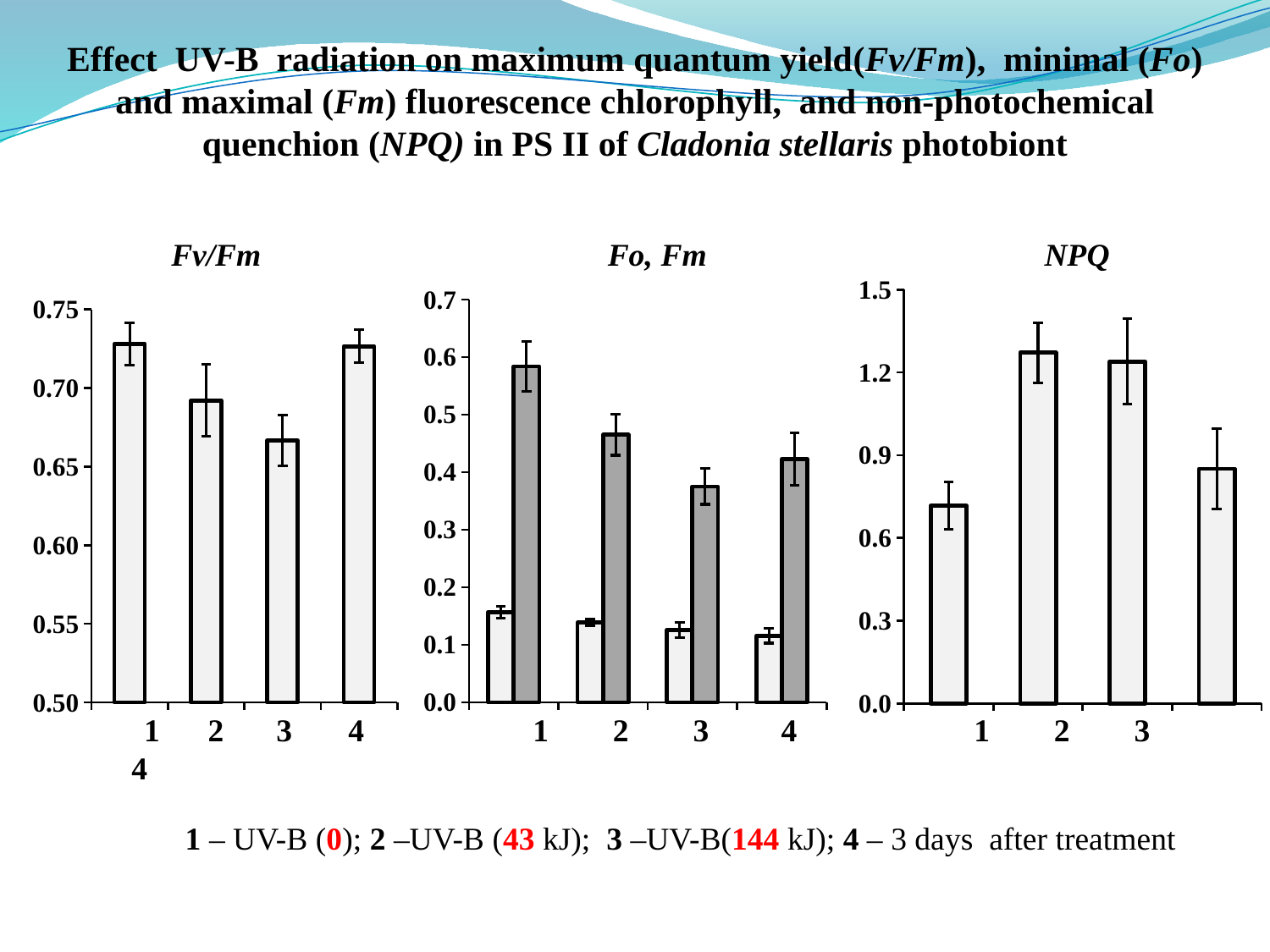
In the Fv/Fm chart, which category has the lowest value? 3 In the Fo, Fm chart, which category has the highest dark grey bar? 1 In the Fv/Fm chart, how many categories are shown on the x axis? 4 In the Fo, Fm chart, is the light grey bar for category 1 greater or less than 0.2? less In the Fv/Fm chart, is the value for category 1 greater or less than 0.70? greater In the Fv/Fm chart, is the value for category 3 greater or less than 0.70? less In the Fo, Fm chart, do the dark grey bars rise or fall from category 1 to category 3? fall What kind of chart is the Fv/Fm chart? bar chart In the NPQ chart, which category has the lowest value? 1 How many charts are shown on the slide? 3